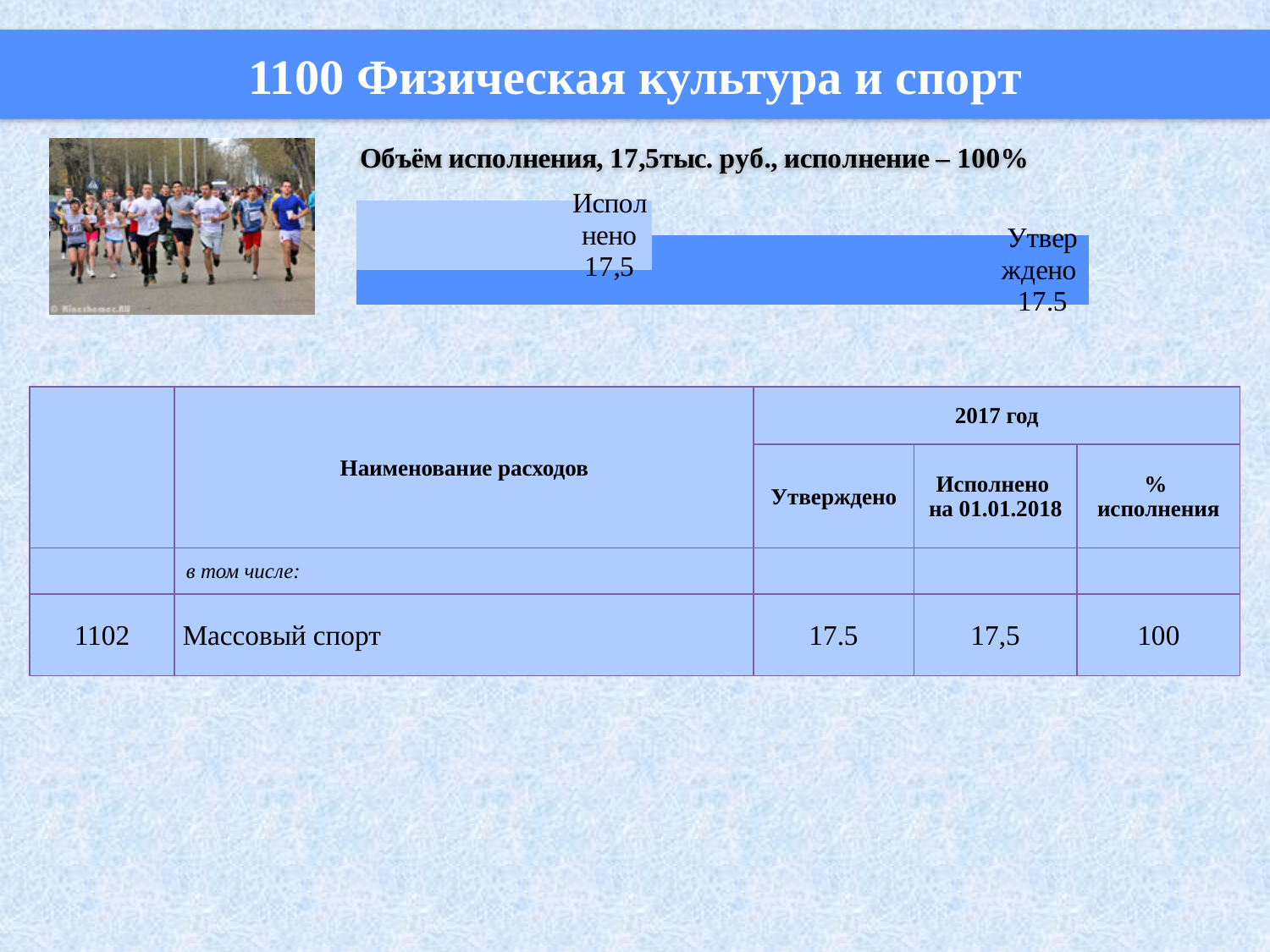
What value is shown for Утверждено in the bar chart? 17.5 How many bars does the chart show? 2 What is the difference between the Утверждено and Исполнено values in the chart? 0 Are the bars in the chart horizontal or vertical? horizontal Is the value for Исполнено in the chart greater or less than 10? greater What value is shown for Исполнено in the bar chart? 17,5 What kind of chart is shown on the slide? bar chart Is the value for Утверждено in the chart greater or less than 20? less Which bar in the chart is drawn in the darker blue colour? Утверждено